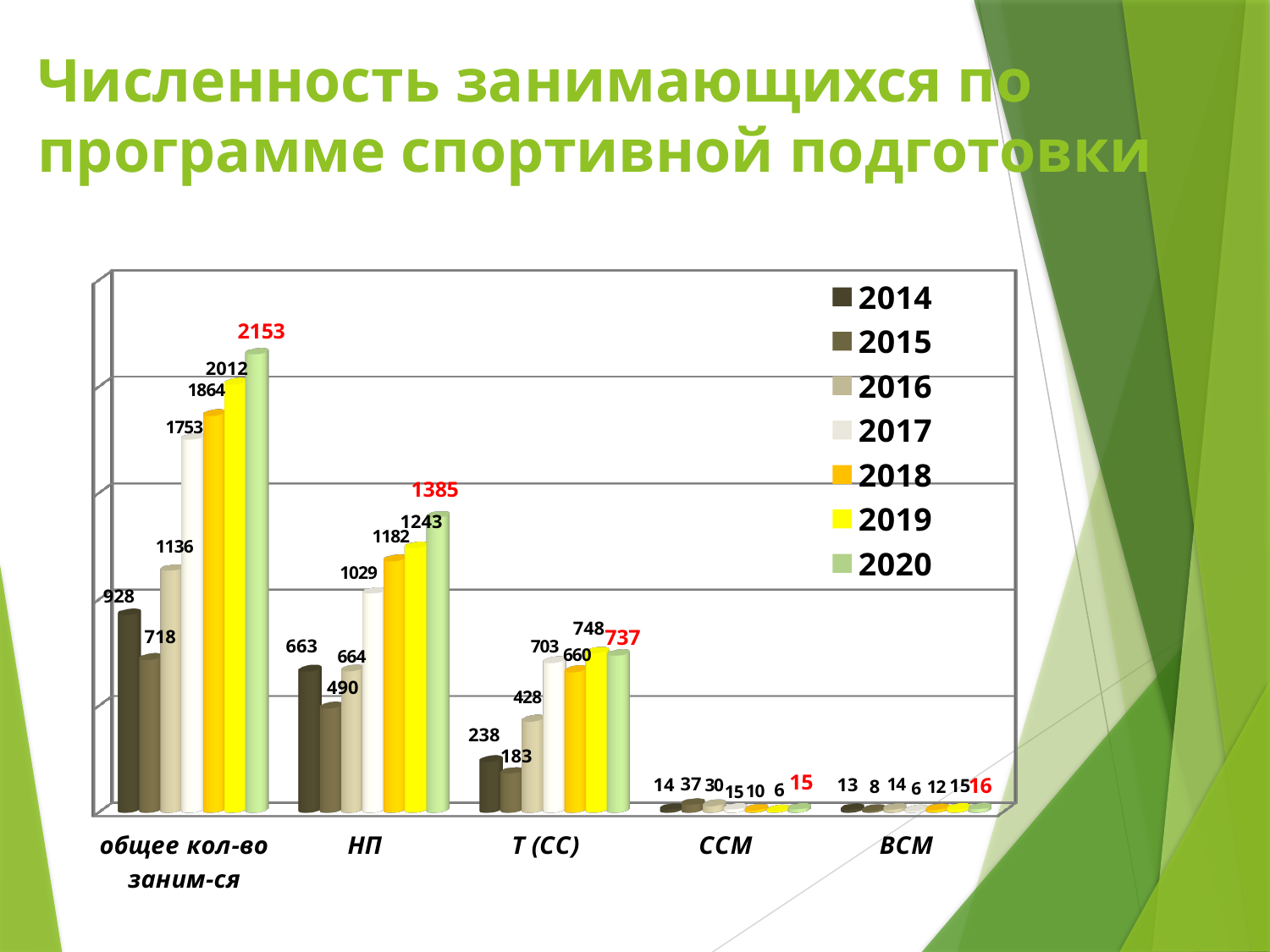
What is the value for 2014 in the "ССМ" category? 14 How many categories are shown on the x axis? 5 Which year has the highest value in the "ВСМ" category? 2020 Which is larger in the "Т (СС)" category: the 2019 value or the 2020 value? 2019 How many series does the legend list? 7 What is the value for 2020 in the "общее кол-во заним-ся" category? 2153 What kind of chart is shown on the slide? Bar chart What is the value for 2015 in the "Т (СС)" category? 183 Which year has the highest value in the "НП" category? 2020 What is the value for 2017 in the "НП" category? 1029 Which year has the lowest value in the "общее кол-во заним-ся" category? 2015 What is the difference between the 2020 and 2019 values in the "общее кол-во заним-ся" category? 141